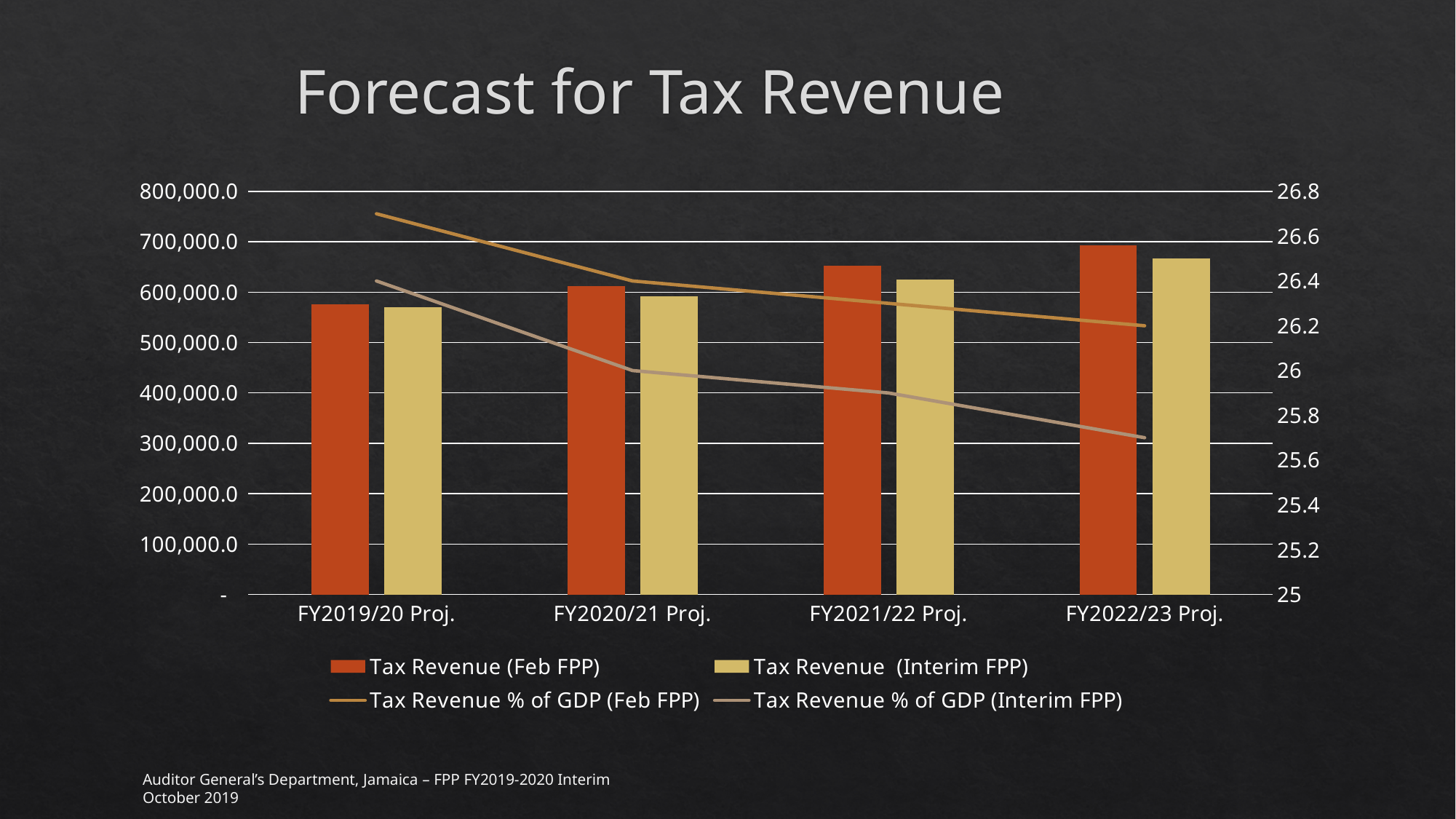
What is the title of the chart? Forecast for Tax Revenue For FY2021/22 Proj., which is larger: Tax Revenue (Feb FPP) or Tax Revenue (Interim FPP)? Tax Revenue (Feb FPP) How many series does the legend list? 4 Which fiscal year has the lowest Tax Revenue (Interim FPP) bar? FY2019/20 Proj. Which fiscal year has the highest Tax Revenue (Feb FPP) bar? FY2022/23 Proj. Is the Tax Revenue (Interim FPP) value for FY2022/23 Proj. greater or less than 600,000.0? greater Is the Tax Revenue (Feb FPP) value for FY2019/20 Proj. greater or less than 600,000.0? less Does the Tax Revenue % of GDP (Interim FPP) line rise or fall from FY2019/20 Proj. to FY2022/23 Proj.? Fall Is the Tax Revenue % of GDP (Feb FPP) value for FY2019/20 Proj. greater or less than 26.6? greater How many fiscal year categories are shown on the x axis? 4 What kind of chart is shown on the slide? Combined bar and line chart Do the Tax Revenue (Feb FPP) bars rise or fall across the fiscal years from left to right? Rise